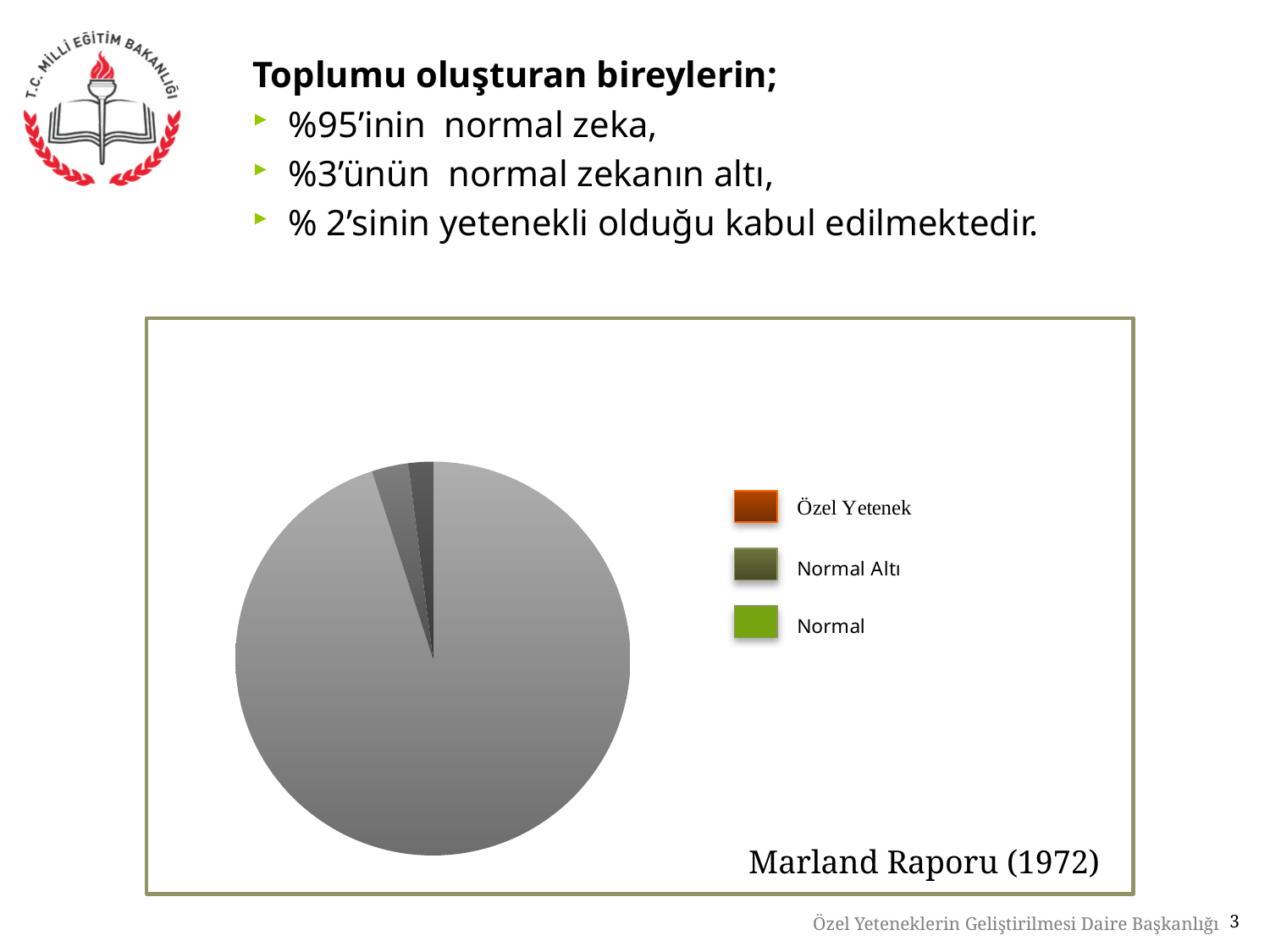
Which category has the smallest slice in the pie chart? Özel Yetenek Which slice is larger in the pie chart, Normal or Özel Yetenek? Normal What kind of chart is shown on the slide? pie chart How many slices does the pie chart have? 3 Which legend entry is shown with an orange colour swatch? Özel Yetenek Which slice is larger in the pie chart, Normal or Normal Altı? Normal Which category has the largest slice in the pie chart? Normal How many entries does the legend of the pie chart list? 3 What source is cited in the bottom-right corner of the chart area? Marland Raporu (1972)